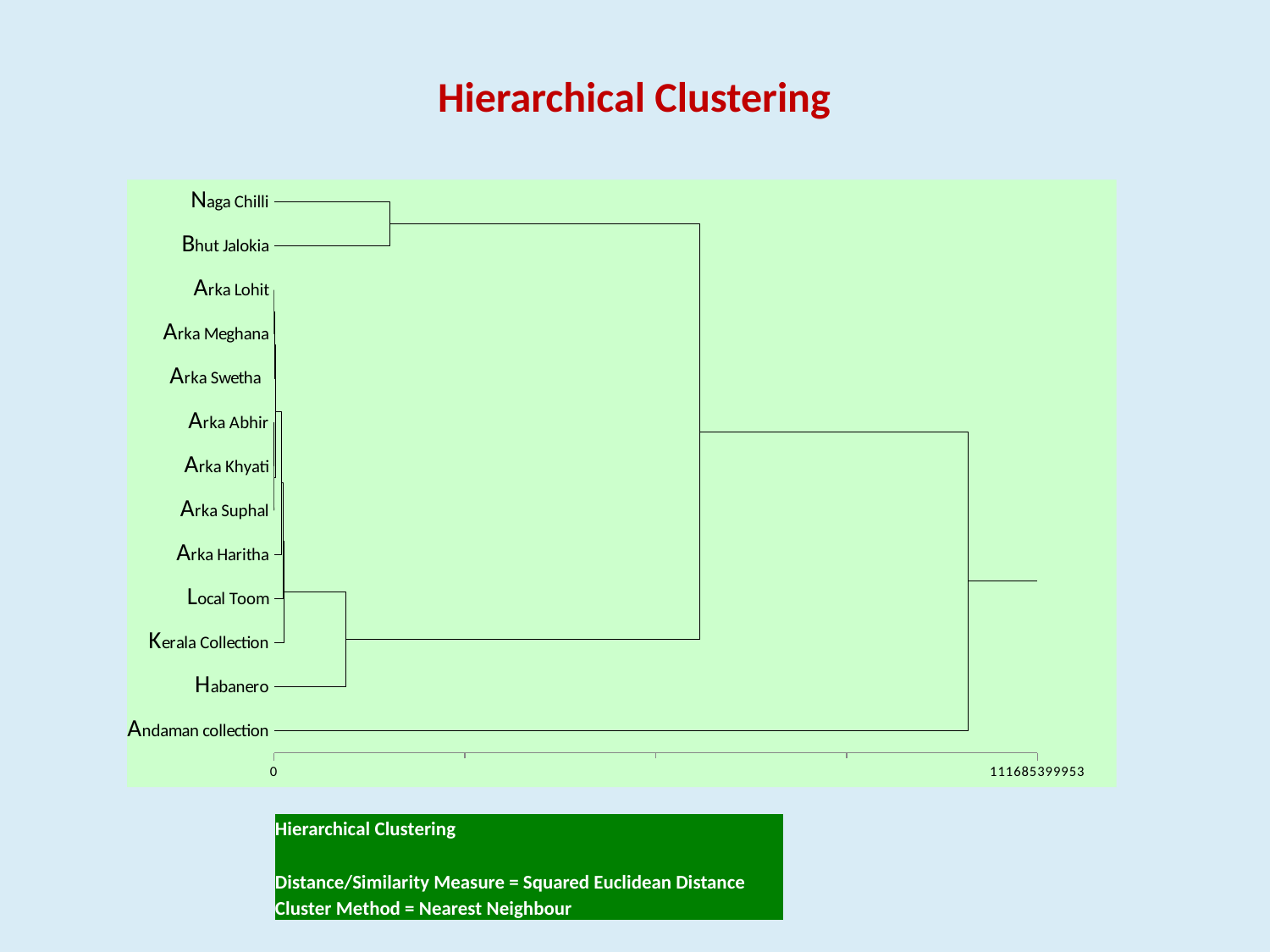
Which item is listed last (at the bottom) on the vertical axis? Andaman collection What is the minimum value labelled on the horizontal axis of the dendrogram? 0 What is the title of the chart on the slide? Hierarchical Clustering Is the Naga Chilli–Bhut Jalokia pair joined at a smaller or larger distance than the Local Toom–Kerala Collection pair? larger According to the text box below the chart, what distance/similarity measure was used? Squared Euclidean Distance What is the maximum value labelled on the horizontal axis of the dendrogram? 111685399953 Which item is clustered together with Naga Chilli? Bhut Jalokia What kind of chart is shown on the slide? Dendrogram (hierarchical clustering tree) Which item is joined to the rest of the tree last, at the largest distance? Andaman collection Which item is listed first (at the top) on the vertical axis? Naga Chilli How many items (leaves) are listed on the vertical axis of the dendrogram? 13